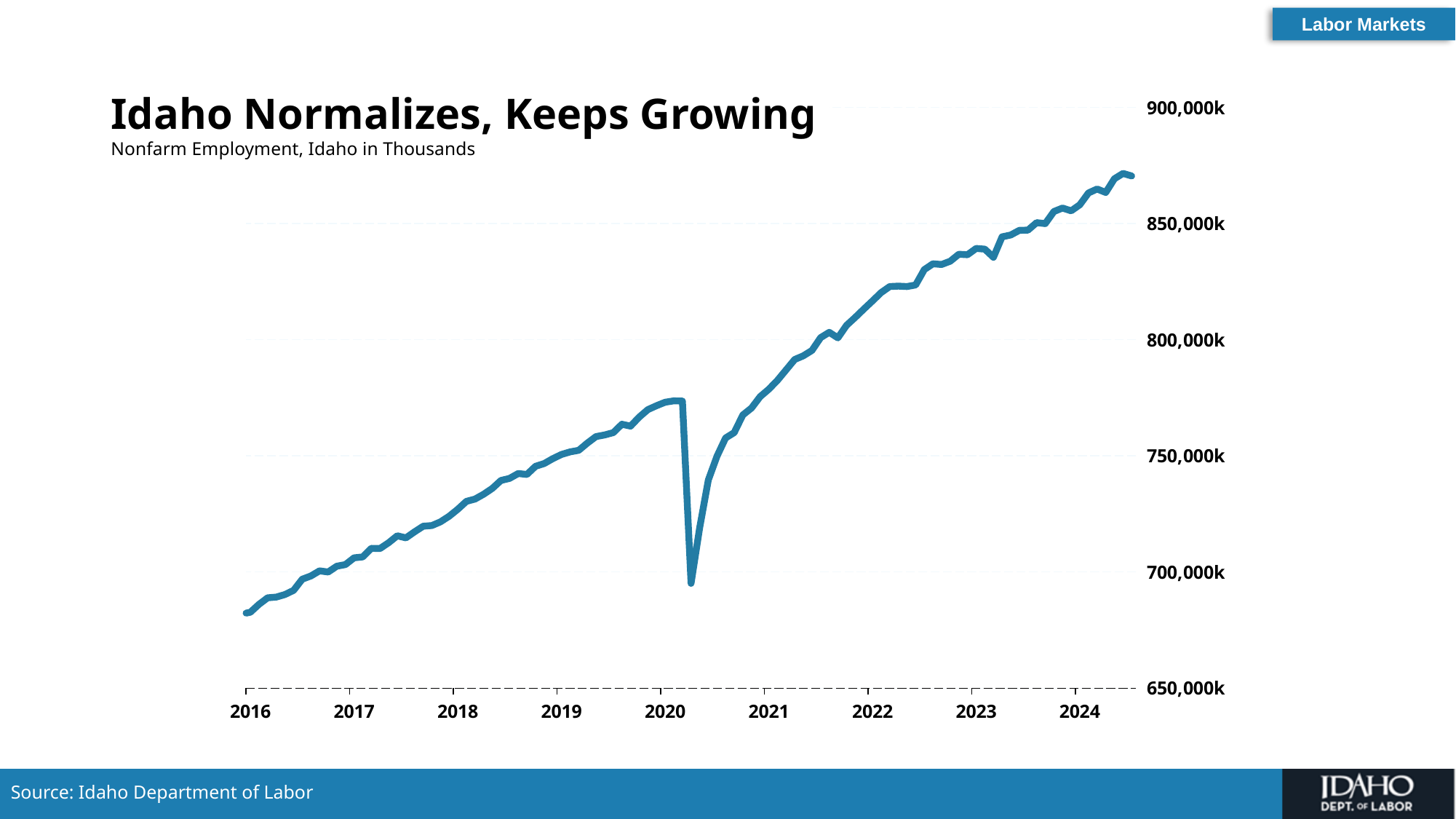
What is the title of the chart? Idaho Normalizes, Keeps Growing Is the value at the start of 2022 greater or less than 800,000k? greater How many year labels are shown on the x axis? 9 What is the subtitle of the chart? Nonfarm Employment, Idaho in Thousands Is the value at the end of the series in 2024 greater or less than 850,000k? greater What kind of chart is shown on the slide? line chart Is the value at the start of 2019 greater or less than 800,000k? less Overall, do the values rise or fall from 2016 to 2024? rise Which is larger, the value at the start of 2018 or the value at the start of 2023? the value at the start of 2023 In which year does the line show a sharp, sudden drop? 2020